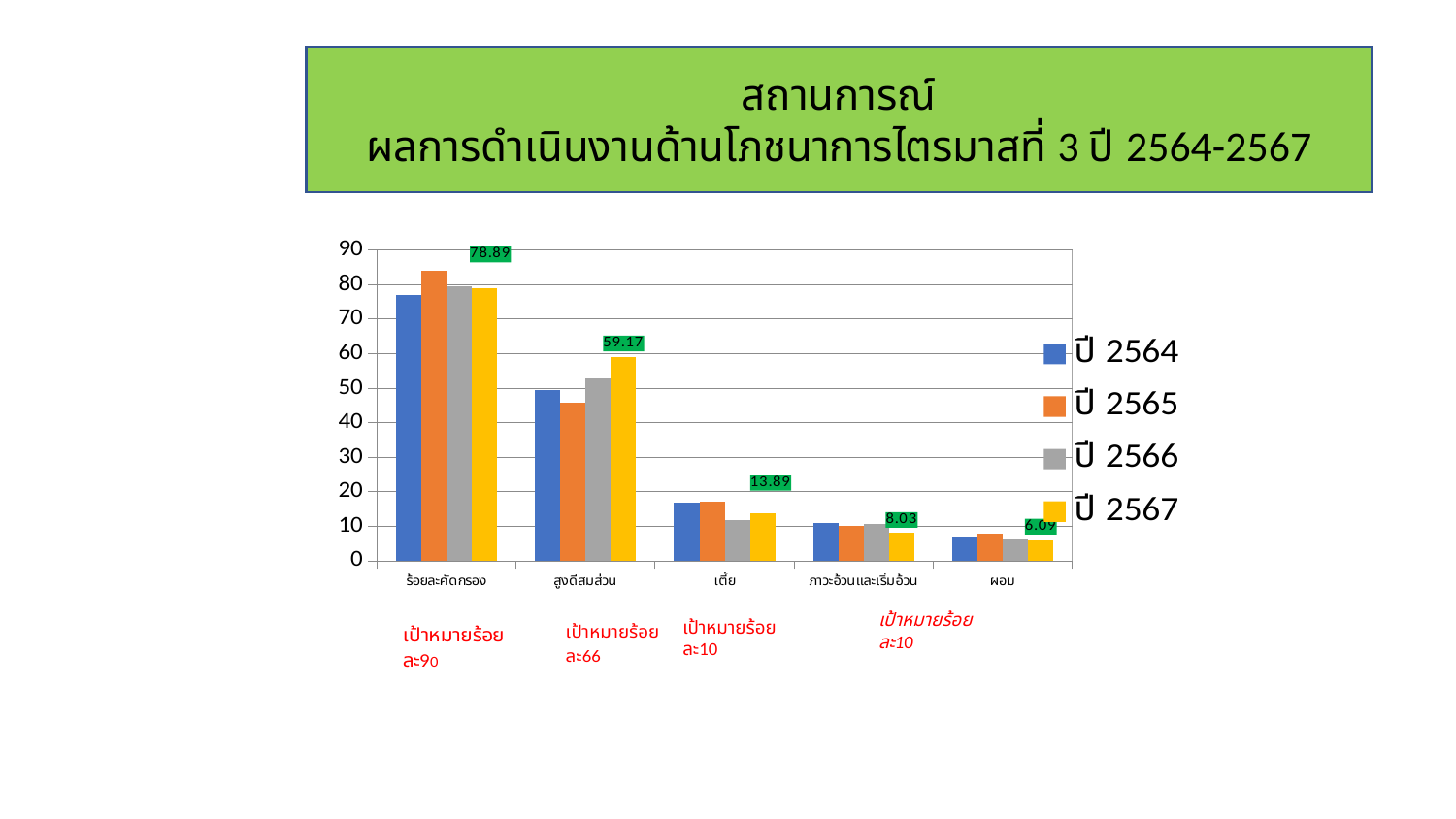
What is the value for ปี 2567 in the ร้อยละคัดกรอง category? 78.89 What is the value for ปี 2567 in the ผอม category? 6.09 What is the value for ปี 2567 in the เตี้ย category? 13.89 What is the difference between the ปี 2567 values for ร้อยละคัดกรอง and สูงดีสมส่วน? 19.72 What is the value for ปี 2567 in the สูงดีสมส่วน category? 59.17 What is the value for ปี 2567 in the ภาวะอ้วนและเริ่มอ้วน category? 8.03 How many series does the legend list? 4 Is the value for ปี 2564 in the ร้อยละคัดกรอง category greater or less than 70? greater What type of chart is shown on the slide? bar chart Which category has the highest value for ปี 2567? ร้อยละคัดกรอง Which category has the lowest value for ปี 2567? ผอม How many categories are shown on the x axis? 5